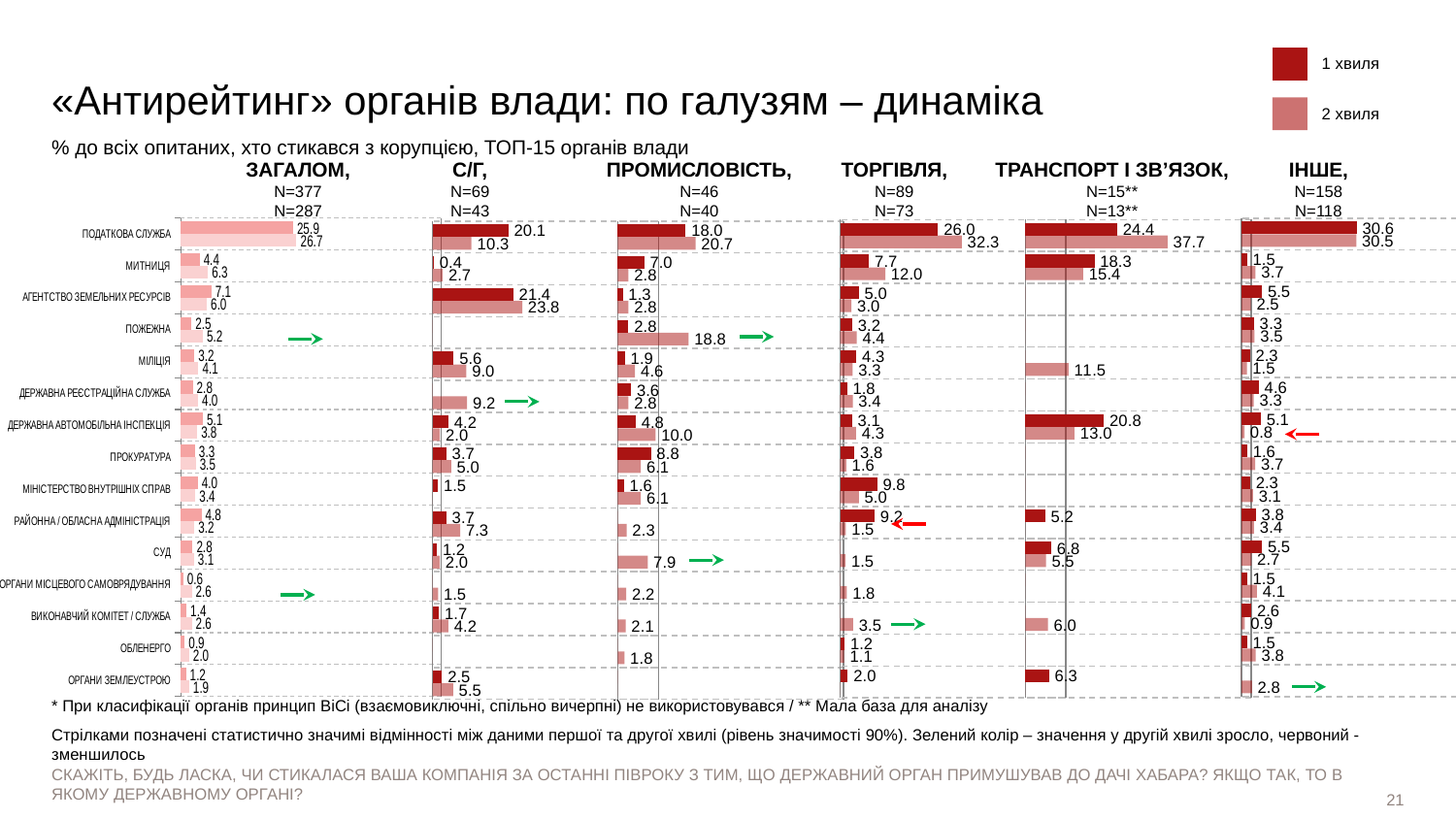
In the ЗАГАЛОМ chart, which category has the lowest 1 хвиля value? ОРГАНИ МІСЦЕВОГО САМОВРЯДУВАННЯ In the ПРОМИСЛОВІСТЬ chart, what is the difference between the 2 хвиля and 1 хвиля values for ПОЖЕЖНА? 16.0 In the ТРАНСПОРТ І ЗВ'ЯЗОК chart, which is larger for МИТНИЦЯ: the 1 хвиля value or the 2 хвиля value? 1 хвиля What kind of chart is used for each industry panel on the slide? Bar chart In the ТОРГІВЛЯ chart, what is the value for МИТНИЦЯ in the 1 хвиля series? 7.7 In the ТРАНСПОРТ І ЗВ'ЯЗОК chart, what is the 2 хвиля value for ПОДАТКОВА СЛУЖБА? 37.7 How many categories (органи влади) are listed on the vertical axis of the ЗАГАЛОМ chart? 15 In the С/Г chart, which category has the highest 2 хвиля value? АГЕНТСТВО ЗЕМЕЛЬНИХ РЕСУРСІВ How many series does the legend list? 2 In the ЗАГАЛОМ chart, what is the value for ПОДАТКОВА СЛУЖБА in the 2 хвиля series? 26.7 In the ІНШЕ chart, which is larger for ДЕРЖАВНА АВТОМОБІЛЬНА ІНСПЕКЦІЯ: the 1 хвиля value or the 2 хвиля value? 1 хвиля In the ТОРГІВЛЯ chart, what is the difference between the 2 хвиля and 1 хвиля values for ПОДАТКОВА СЛУЖБА? 6.3